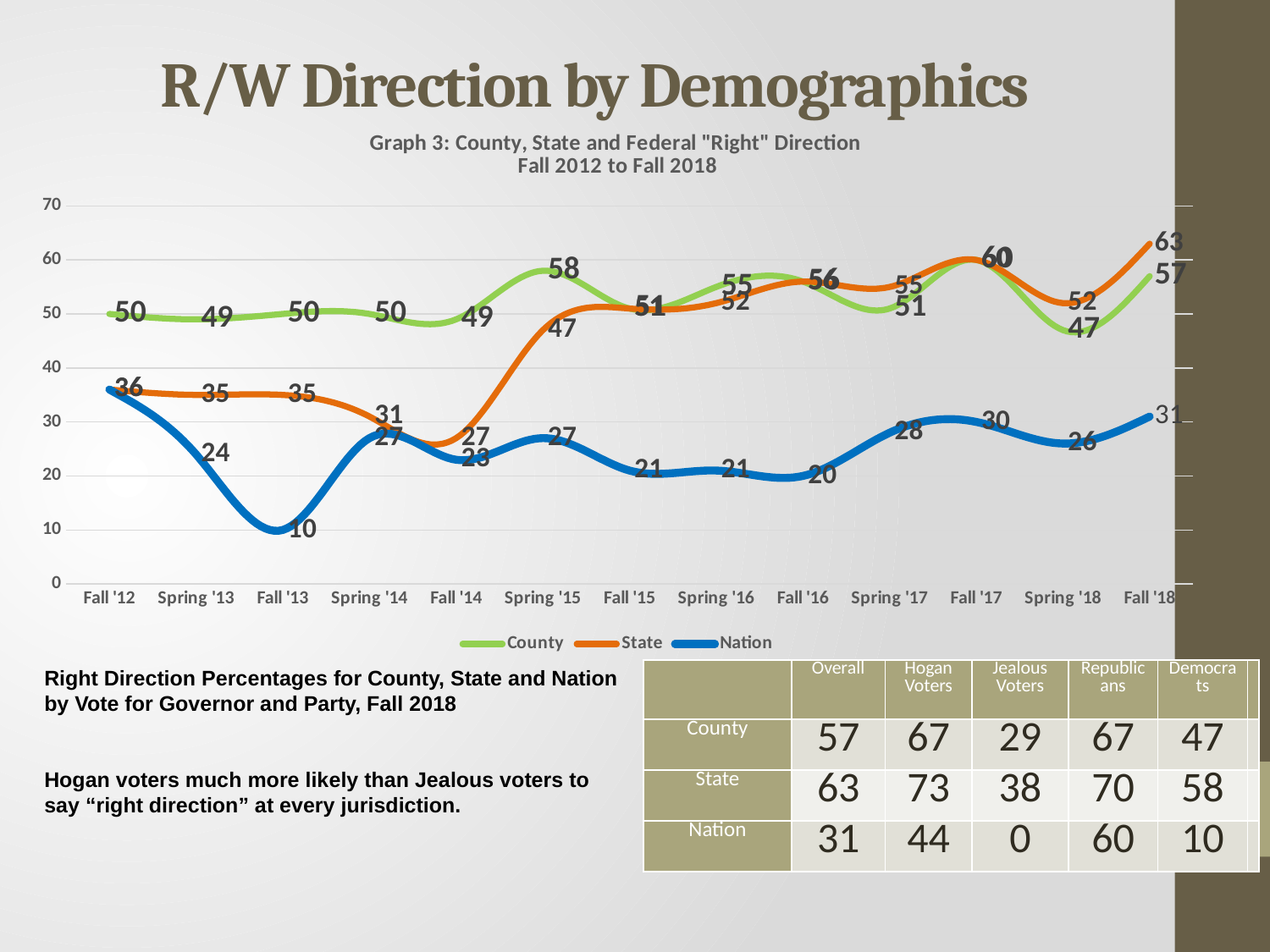
How many time points are shown along the x axis of the chart? 13 Which is larger in Spring '18, the County value or the State value? State Is the value for Nation in Spring '17 greater or less than 30? less What is the difference between the State value and the Nation value in Fall '18? 32 What is the title of the chart? Graph 3: County, State and Federal "Right" Direction Fall 2012 to Fall 2018 What is the value for Nation in Fall '13? 10 What type of chart is shown on the slide? line chart At which time point is the Nation series lowest? Fall '13 At which time point is the State series highest? Fall '18 How many series does the chart legend list? 3 What is the value for State in Fall '18? 63 What is the value for County in Spring '15? 58